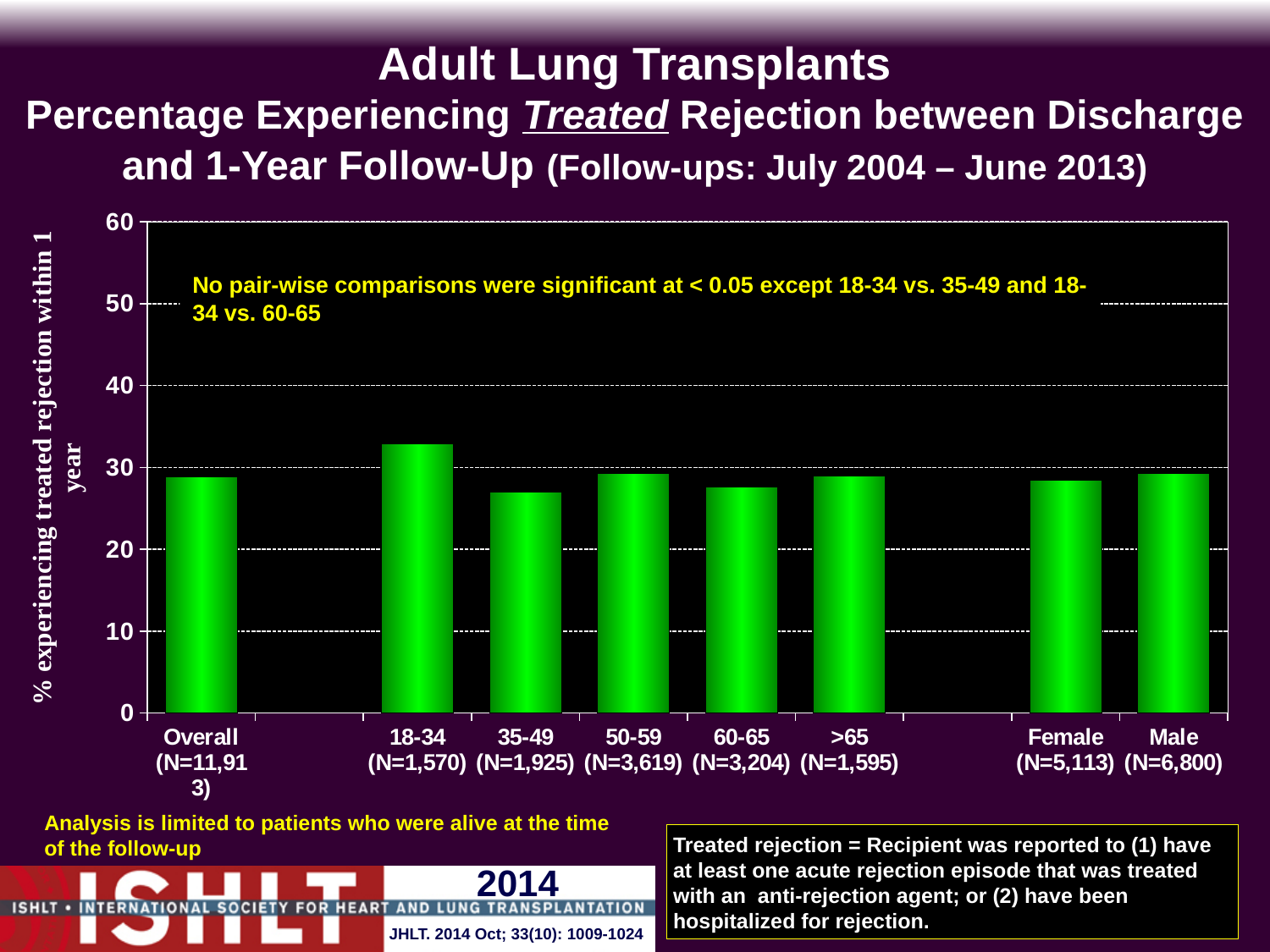
How many bars (categories) are plotted in the chart? 8 Is the value for Female greater or less than 30? less Is the value for the 18-34 age group greater or less than 40? less What is the sample size (N) shown for the Male category? N=6,800 What is the label on the y-axis of the chart? % experiencing treated rejection within 1 year Is the value for the 35-49 age group greater or less than 30? less Which has the larger value, the 18-34 age group or the 35-49 age group? 18-34 What kind of chart is shown on the slide? bar chart Which has the larger value, the 18-34 age group or the 60-65 age group? 18-34 Which category has the highest percentage experiencing treated rejection? 18-34